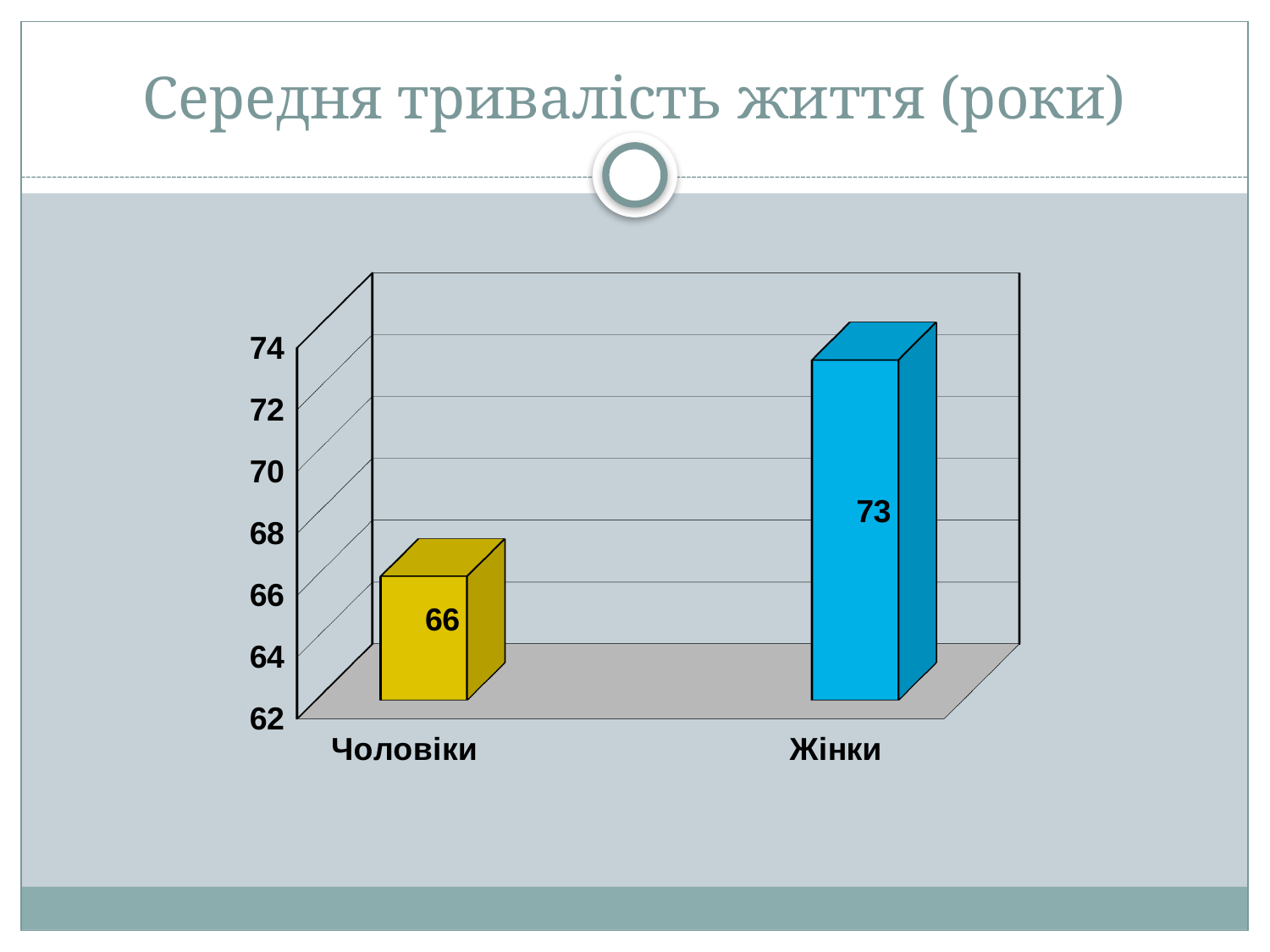
Which category has the lowest value? Чоловіки Which category has the highest value? Жінки Which is larger, the value for Чоловіки or the value for Жінки? Жінки How many categories are shown in the chart? 2 What is the value for Чоловіки? 66 What kind of chart is shown on the slide? bar chart What is the value for Жінки? 73 What colour is the bar for Жінки? blue Is the value for Жінки greater or less than 70? greater Is the value for Чоловіки greater or less than 70? less What is the title of the slide? Середня тривалість життя (роки) What is the difference between the values for Жінки and Чоловіки? 7